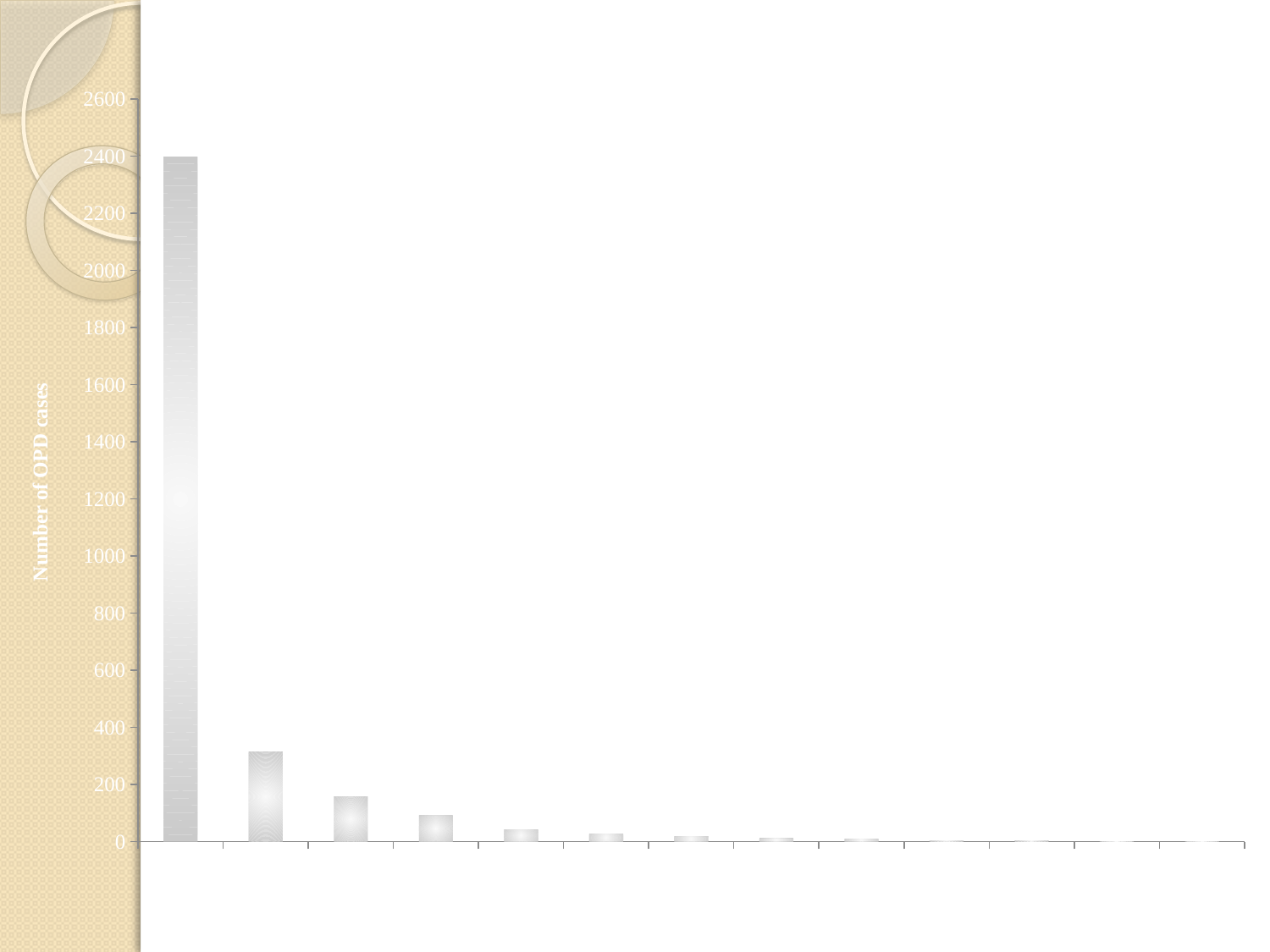
Which is larger, the leftmost bar or the second bar from the left? the leftmost bar What is the highest tick value shown on the vertical axis? 2600 Is the value of the second bar from the left greater or less than 200? greater Is the value of the second bar from the left greater or less than 400? less What is the title of the vertical axis? Number of OPD cases Which bar is the tallest in the chart? the leftmost (first) bar Is the value of the leftmost bar greater or less than 2000? greater What kind of chart is shown on the slide? bar chart Do the bar values rise or fall moving from left to right along the x axis? fall